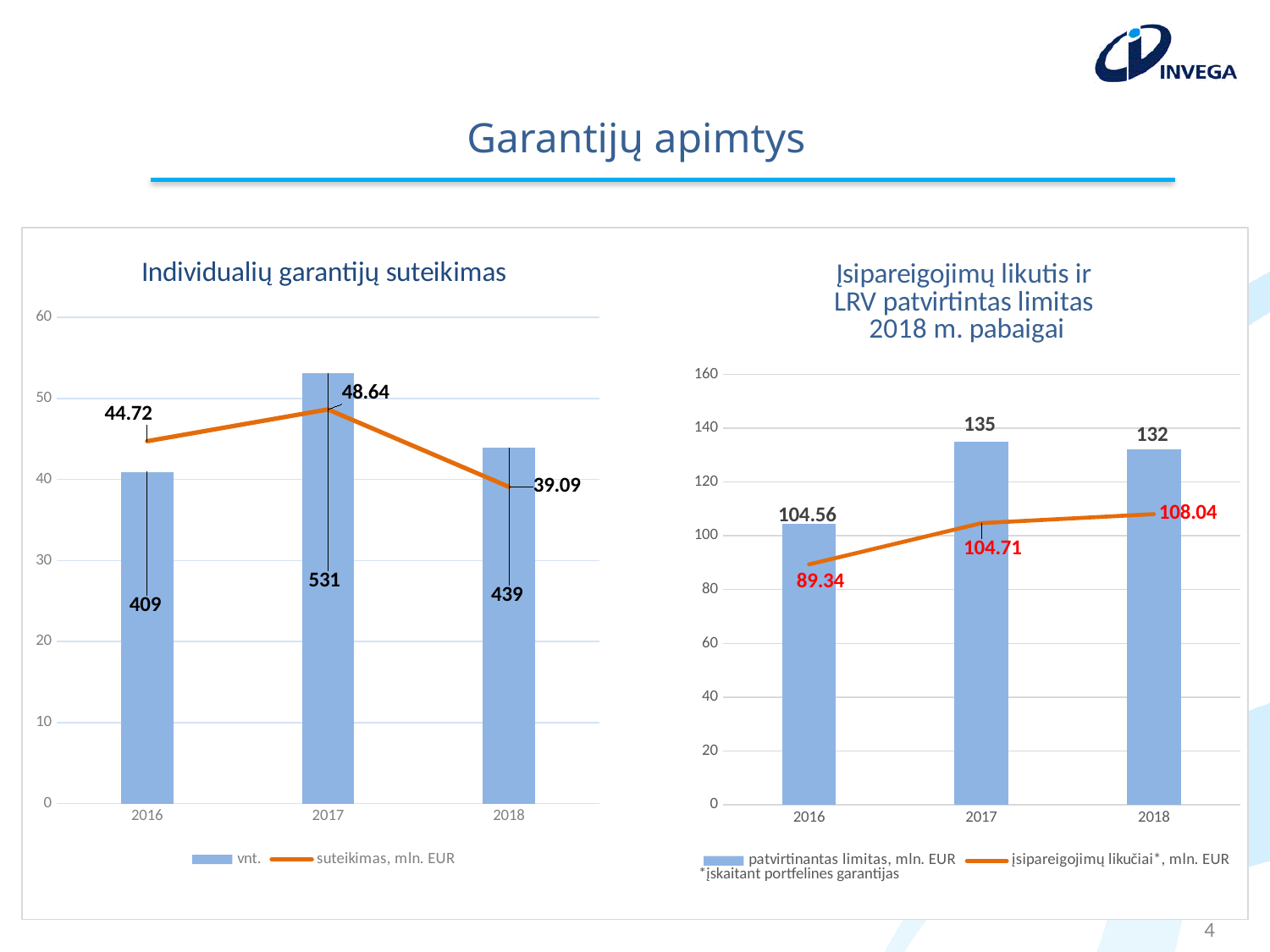
In the chart 'Įsipareigojimų likutis ir LRV patvirtintas limitas 2018 m. pabaigai', what is the 'įsipareigojimų likučiai*, mln. EUR' value for 2017? 104.71 In the chart 'Įsipareigojimų likutis ir LRV patvirtintas limitas 2018 m. pabaigai', does the 'įsipareigojimų likučiai*, mln. EUR' value rise or fall from 2016 to 2018? rise In the chart 'Individualių garantijų suteikimas', which year has the highest 'vnt.' value? 2017 In the chart 'Individualių garantijų suteikimas', what is the 'vnt.' value for 2017? 531 In the chart 'Įsipareigojimų likutis ir LRV patvirtintas limitas 2018 m. pabaigai', which year has the highest 'patvirtinantas limitas, mln. EUR' value? 2017 In the chart 'Individualių garantijų suteikimas', what is the difference between the 'vnt.' values for 2017 and 2016? 122 In the chart 'Individualių garantijų suteikimas', how many series does the legend list? 2 How many years are shown on the x axis of the chart 'Įsipareigojimų likutis ir LRV patvirtintas limitas 2018 m. pabaigai'? 3 In the chart 'Individualių garantijų suteikimas', what is the 'suteikimas, mln. EUR' value for 2018? 39.09 In the chart 'Individualių garantijų suteikimas', which year has the lowest 'suteikimas, mln. EUR' value? 2018 In the chart 'Įsipareigojimų likutis ir LRV patvirtintas limitas 2018 m. pabaigai', what is the 'patvirtinantas limitas, mln. EUR' value for 2016? 104.56 In the chart 'Įsipareigojimų likutis ir LRV patvirtintas limitas 2018 m. pabaigai', which is larger in 2018: 'patvirtinantas limitas, mln. EUR' or 'įsipareigojimų likučiai*, mln. EUR'? patvirtinantas limitas, mln. EUR